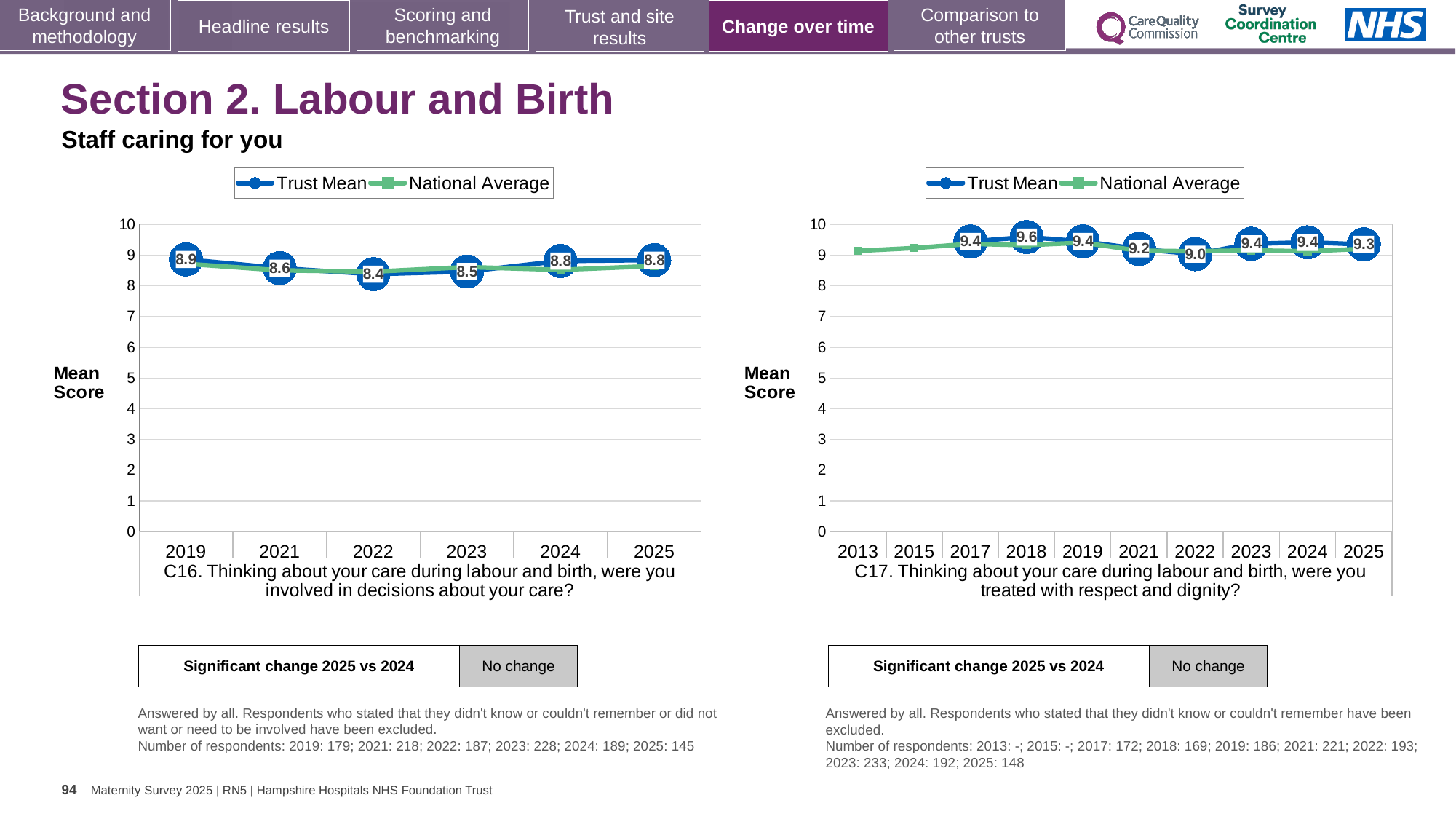
In the C17 chart (right), what is the Trust Mean for 2025? 9.3 In the C16 chart (left), what is the Trust Mean for 2019? 8.9 In the C16 chart (left), what is the difference between the Trust Mean in 2019 and in 2022? 0.5 In the C16 chart (left), what is the Trust Mean for 2022? 8.4 In the C17 chart (right), is the Trust Mean for 2021 larger or smaller than the Trust Mean for 2022? larger In the C17 chart (right), what is the Trust Mean for 2018? 9.6 What kind of chart is the C16 chart (left)? line chart In the C17 chart (right), which year has the highest Trust Mean? 2018 In the C17 chart (right), which year has the lowest Trust Mean? 2022 In the C16 chart (left), how many years are shown on the x axis? 6 In the C16 chart (left), which year has the lowest Trust Mean? 2022 How many series does the legend of the C17 chart (right) list? 2